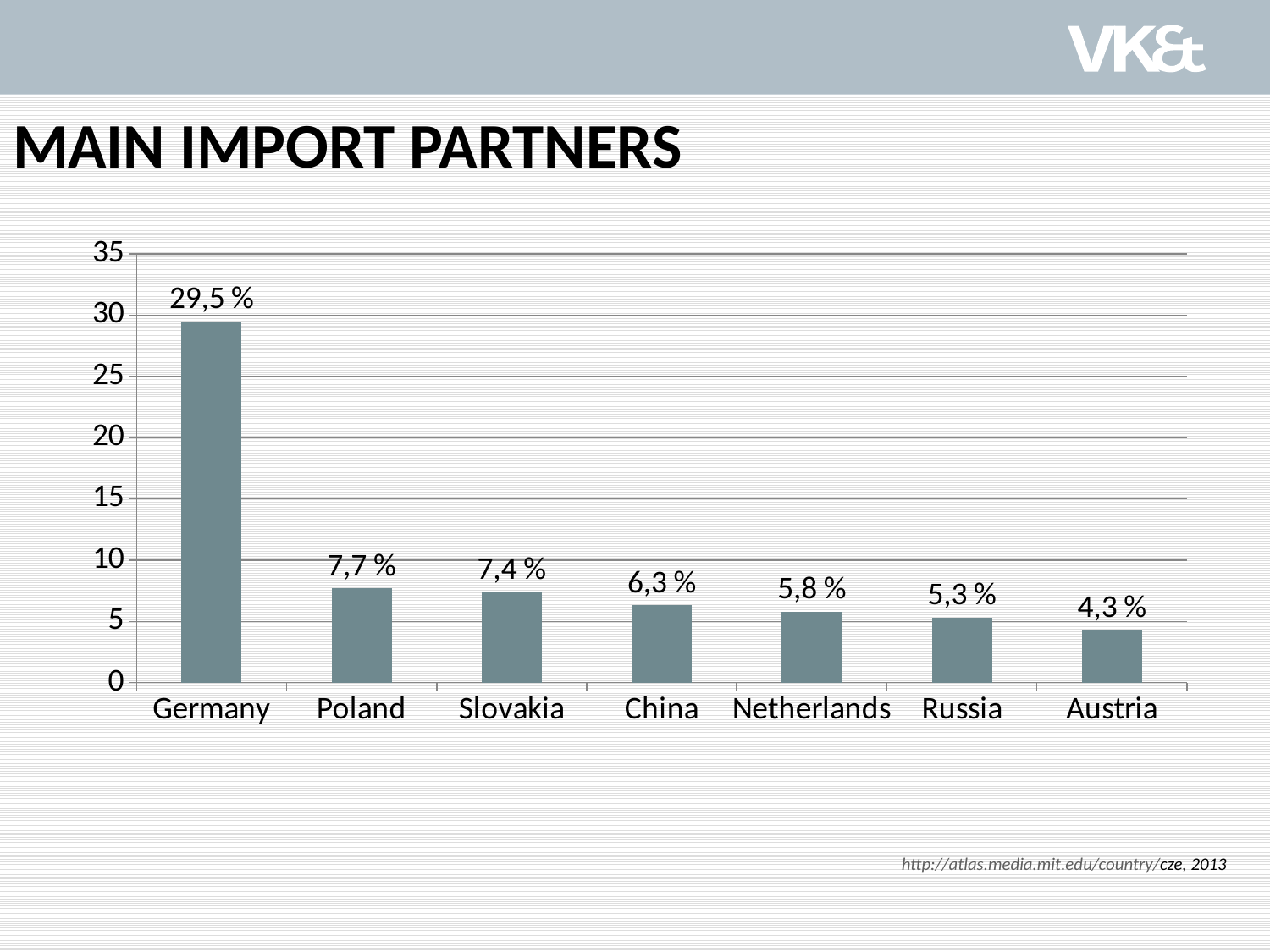
What kind of chart is shown on the slide? bar chart Which country has the lowest value? Austria What is the difference between the values for Germany and Poland? 21,8 % What is the difference between the values for China and Russia? 1,0 % How many countries are shown on the chart? 7 Which country has the highest value? Germany Is the value for Germany greater or less than 25? greater What is the value for Germany? 29,5 % Which is larger, the value for Slovakia or the value for Netherlands? Slovakia What is the title of the slide? MAIN IMPORT PARTNERS What is the value for Netherlands? 5,8 % What is the value for Austria? 4,3 %